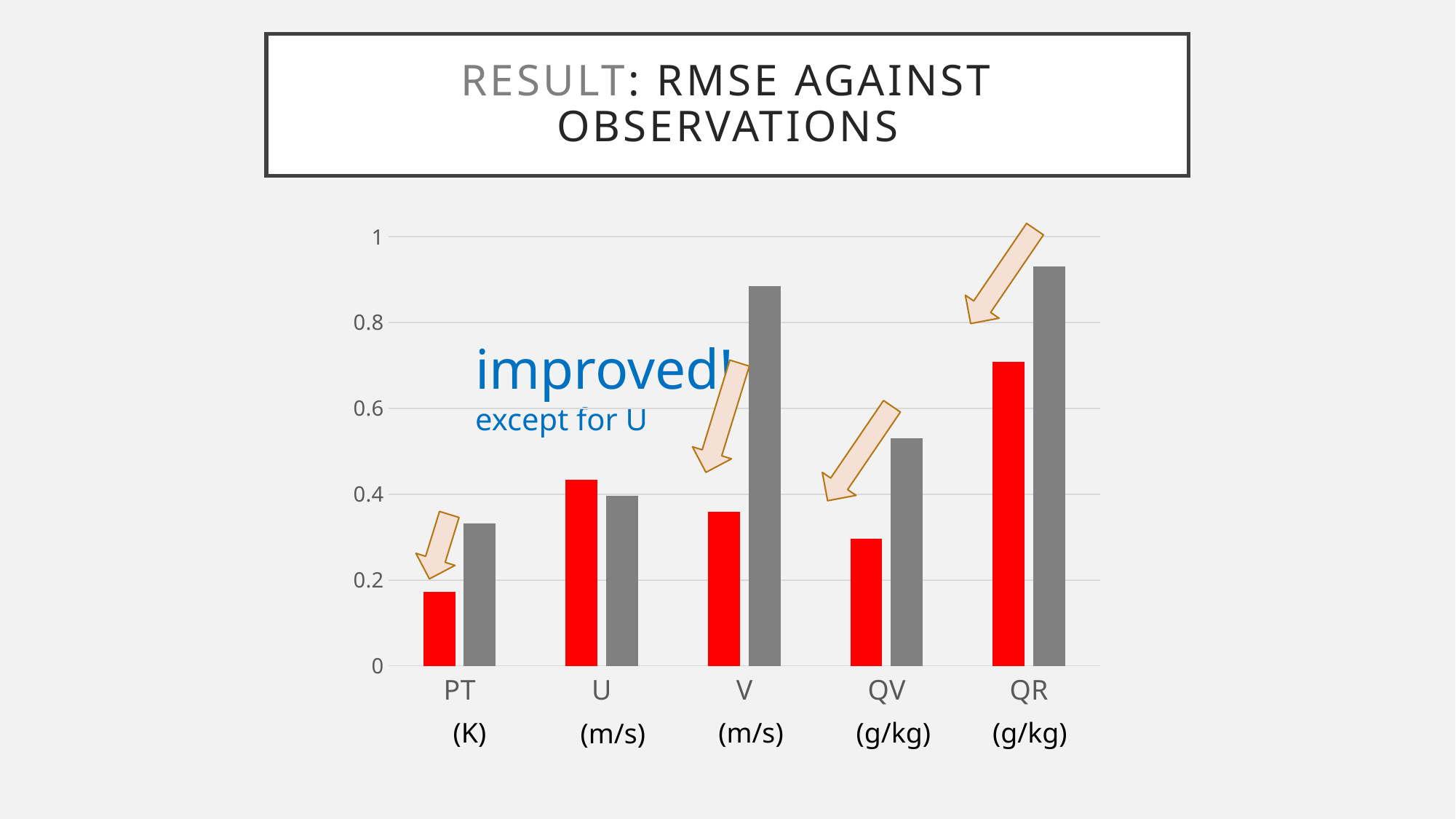
Is the gray bar for V greater or less than 0.8? greater Is the gray bar for QV greater or less than 0.4? greater What kind of chart is shown on the slide? bar chart What is the title of the slide containing the chart? RESULT: RMSE AGAINST OBSERVATIONS Is the red bar for QR greater or less than 0.6? greater Which category has the shortest red bar? PT Which category has the tallest red bar? QR According to the annotation on the chart, which category is the exception to the improvement? U For category V, which bar is taller, the red bar or the gray bar? the gray bar Which category has the tallest gray bar? QR How many categories are shown on the x axis of the chart? 5